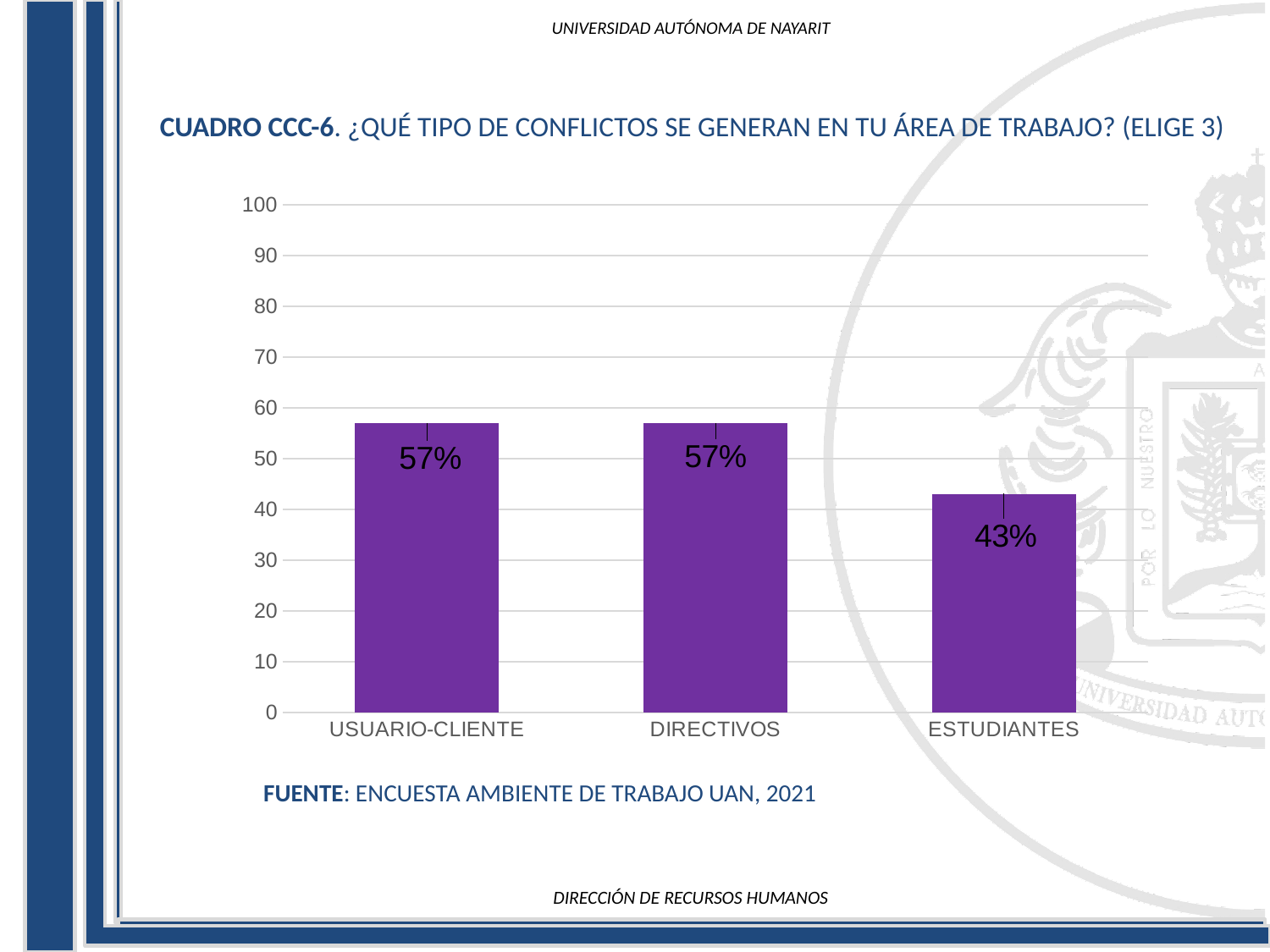
How many categories are shown on the chart? 3 What is the source cited below the chart? ENCUESTA AMBIENTE DE TRABAJO UAN, 2021 What is the difference between the values for USUARIO-CLIENTE and ESTUDIANTES? 14% Is the value for DIRECTIVOS greater or less than 50? greater What is the value for USUARIO-CLIENTE? 57% Which category has the lowest value? ESTUDIANTES What is the value for DIRECTIVOS? 57% What is the maximum value shown on the vertical axis? 100 Is the value for ESTUDIANTES greater or less than 50? less Which is larger, the value for DIRECTIVOS or the value for ESTUDIANTES? DIRECTIVOS What kind of chart is shown on the slide? bar chart What is the value for ESTUDIANTES? 43%